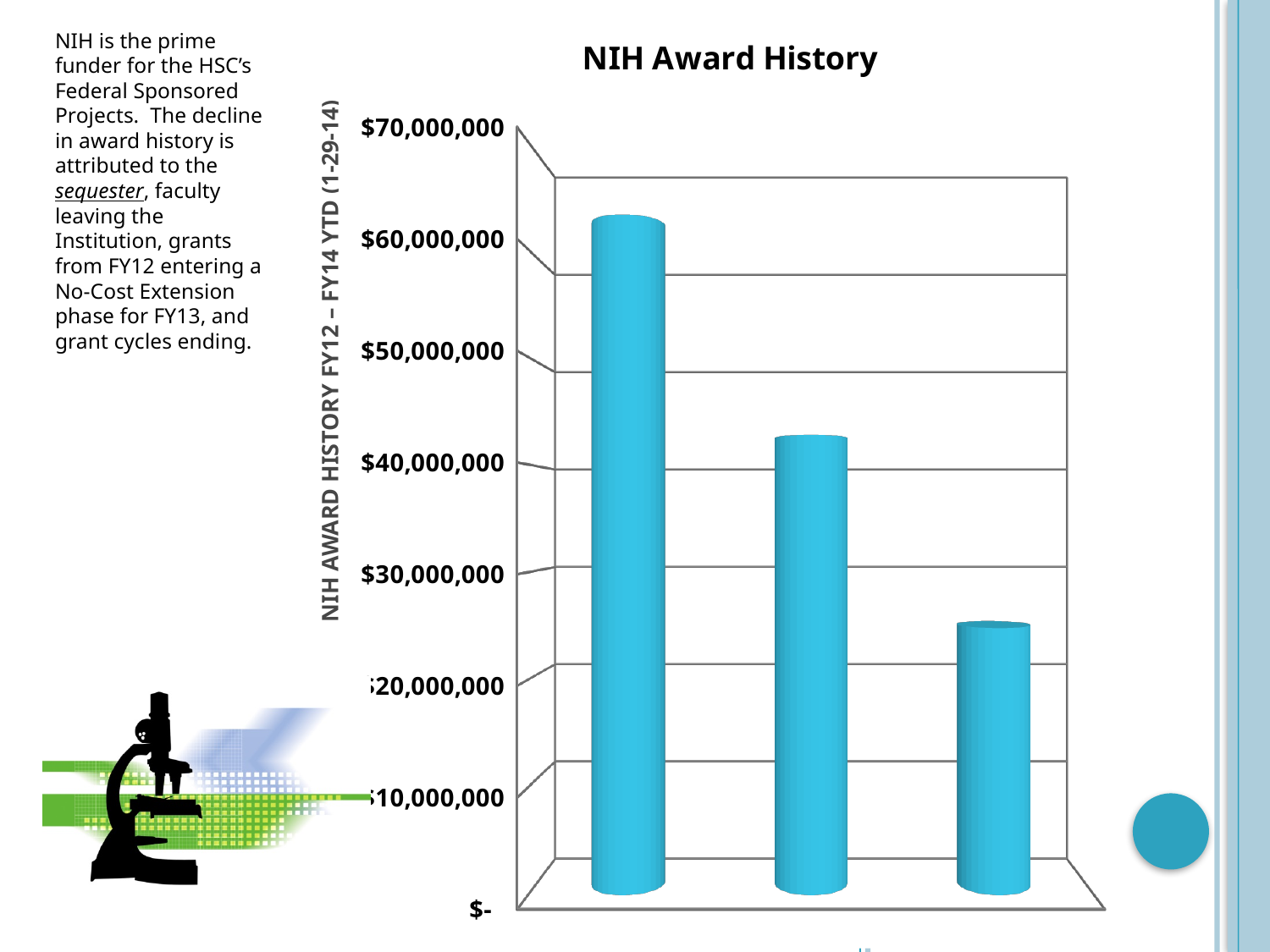
What is the title of the chart? NIH Award History Which is larger, the middle bar or the right bar? middle bar Which bar is the tallest in the chart: the left, middle, or right bar? left Which bar is the shortest in the chart: the left, middle, or right bar? right What kind of chart is shown on the slide? bar chart How many bars are plotted in the NIH Award History chart? 3 What is the label on the vertical axis of the chart? NIH AWARD HISTORY FY12 – FY14 YTD (1-29-14) Is the value of the left bar greater or less than $50,000,000? greater What is the highest value shown on the vertical axis? $70,000,000 Do the bar values rise or fall from left to right across the chart? fall Is the value of the right bar greater or less than $30,000,000? less Is the value of the middle bar greater or less than $40,000,000? greater